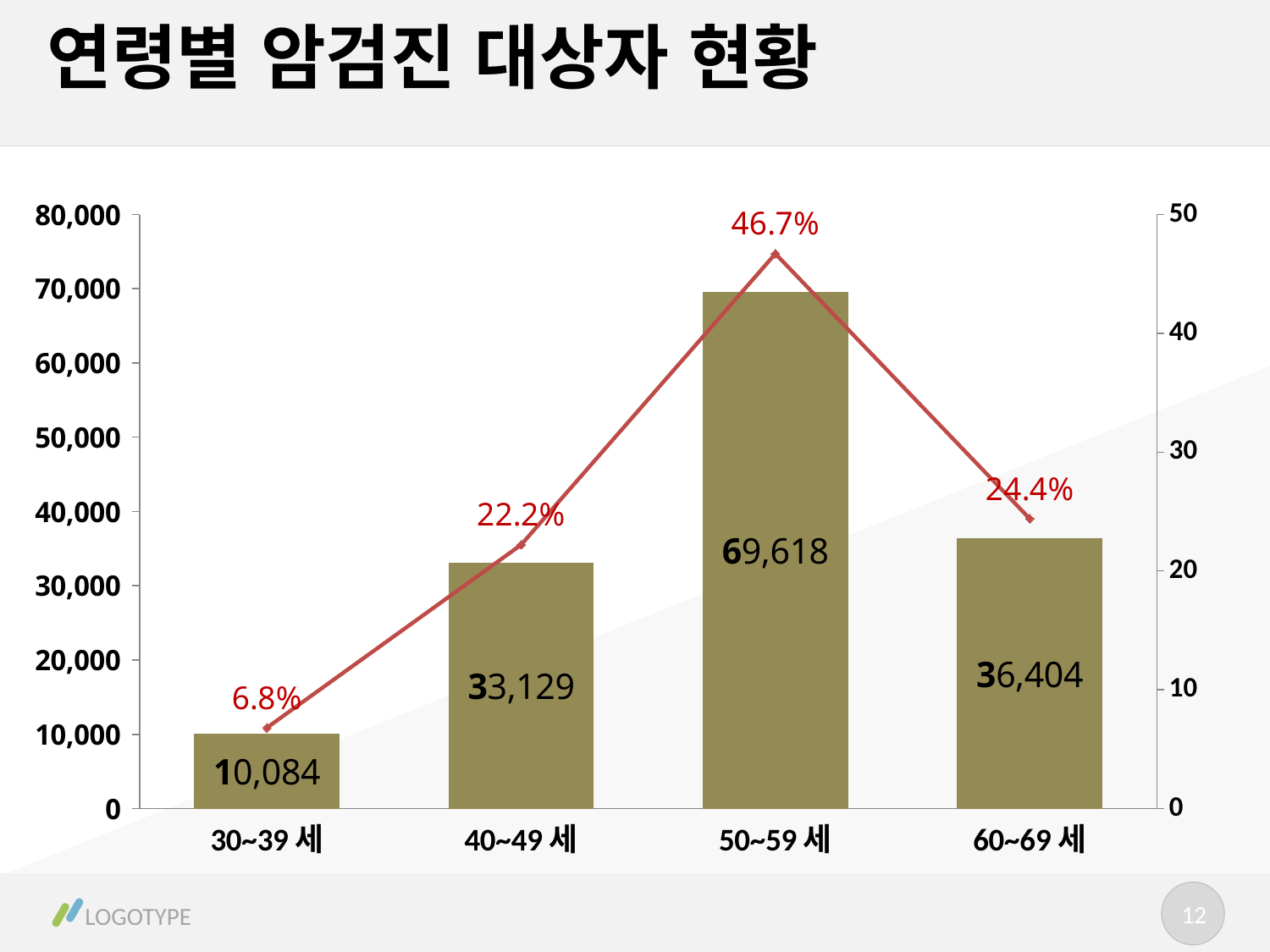
Which age group has the lowest percentage on the line? 30~39 세 Is the bar value for 40~49 세 greater or less than 30,000? greater Which age group has the highest bar value? 50~59 세 How many age groups are shown on the x axis? 4 What percentage is shown on the line for the 60~69 세 age group? 24.4% What is the title of the chart on the slide? 연령별 암검진 대상자 현황 What is the difference between the bar values for 50~59 세 and 60~69 세? 33,214 What is the bar value for the 30~39 세 age group? 10,084 What is the bar value for the 50~59 세 age group? 69,618 Which has a larger bar value, 40~49 세 or 60~69 세? 60~69 세 What kind of chart is shown on the slide? Combined bar and line chart What percentage is shown on the line for the 40~49 세 age group? 22.2%